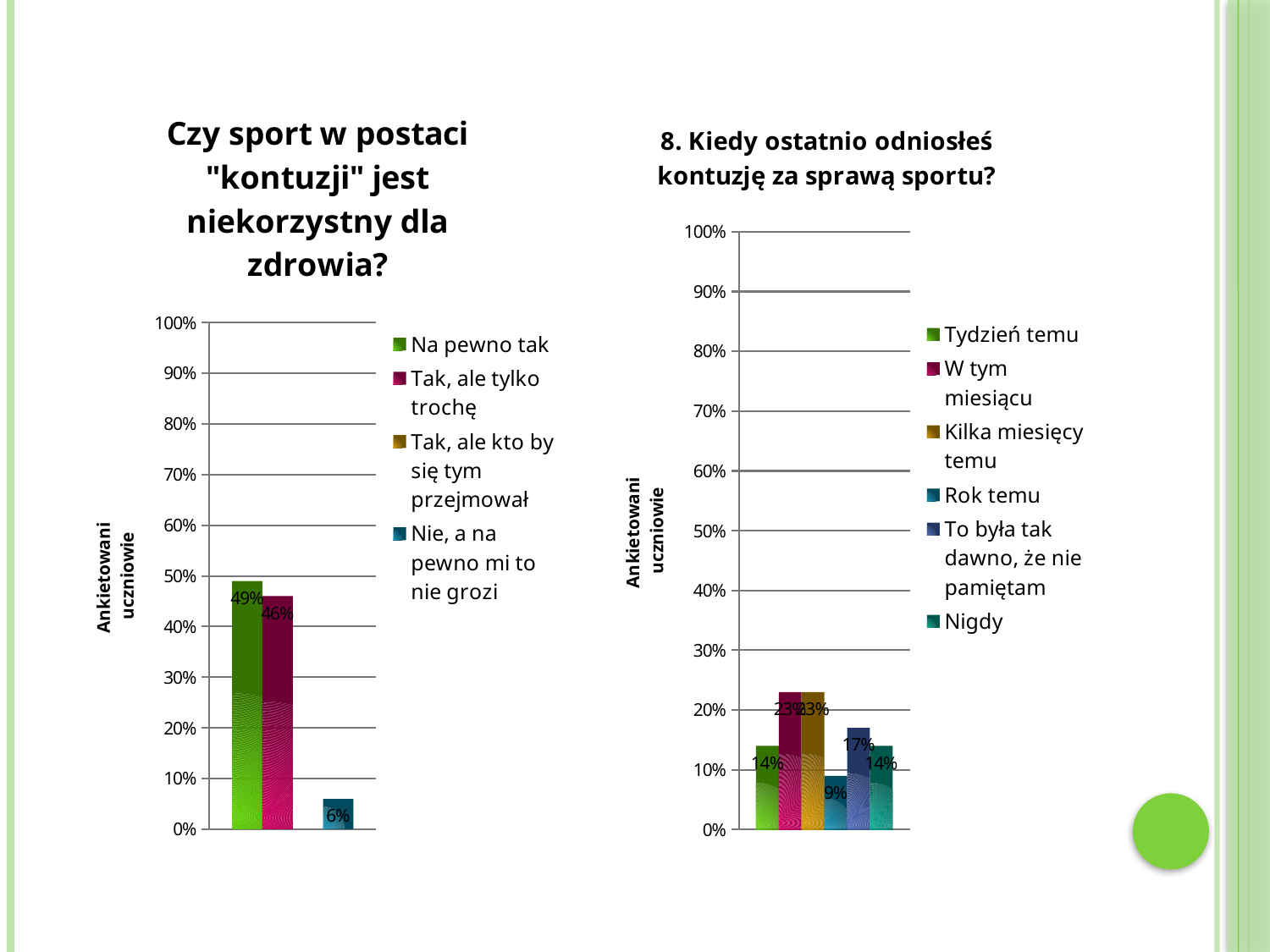
In the chart "8. Kiedy ostatnio odniosłeś kontuzję za sprawą sportu?", what is the value for "Rok temu"? 9% In the chart "8. Kiedy ostatnio odniosłeś kontuzję za sprawą sportu?", which series has the lowest value? Rok temu What kind of chart is the chart on the right side of the slide? Bar chart In the chart "Czy sport w postaci "kontuzji" jest niekorzystny dla zdrowia?", what is the value for "Na pewno tak"? 49% In the chart "Czy sport w postaci "kontuzji" jest niekorzystny dla zdrowia?", how many series does the legend list? 4 In the chart "8. Kiedy ostatnio odniosłeś kontuzję za sprawą sportu?", which is larger: "W tym miesiącu" or "Tydzień temu"? W tym miesiącu In the chart "Czy sport w postaci "kontuzji" jest niekorzystny dla zdrowia?", which series has the highest value? Na pewno tak In the chart "8. Kiedy ostatnio odniosłeś kontuzję za sprawą sportu?", what is the value for "To była tak dawno, że nie pamiętam"? 17% In the chart "Czy sport w postaci "kontuzji" jest niekorzystny dla zdrowia?", what is the difference between "Na pewno tak" and "Tak, ale tylko trochę"? 3% In the chart "8. Kiedy ostatnio odniosłeś kontuzję za sprawą sportu?", what is the difference between "To była tak dawno, że nie pamiętam" and "Nigdy"? 3% In the chart "8. Kiedy ostatnio odniosłeś kontuzję za sprawą sportu?", how many series does the legend list? 6 In the chart "Czy sport w postaci "kontuzji" jest niekorzystny dla zdrowia?", what is the value for "Nie, a na pewno mi to nie grozi"? 6%